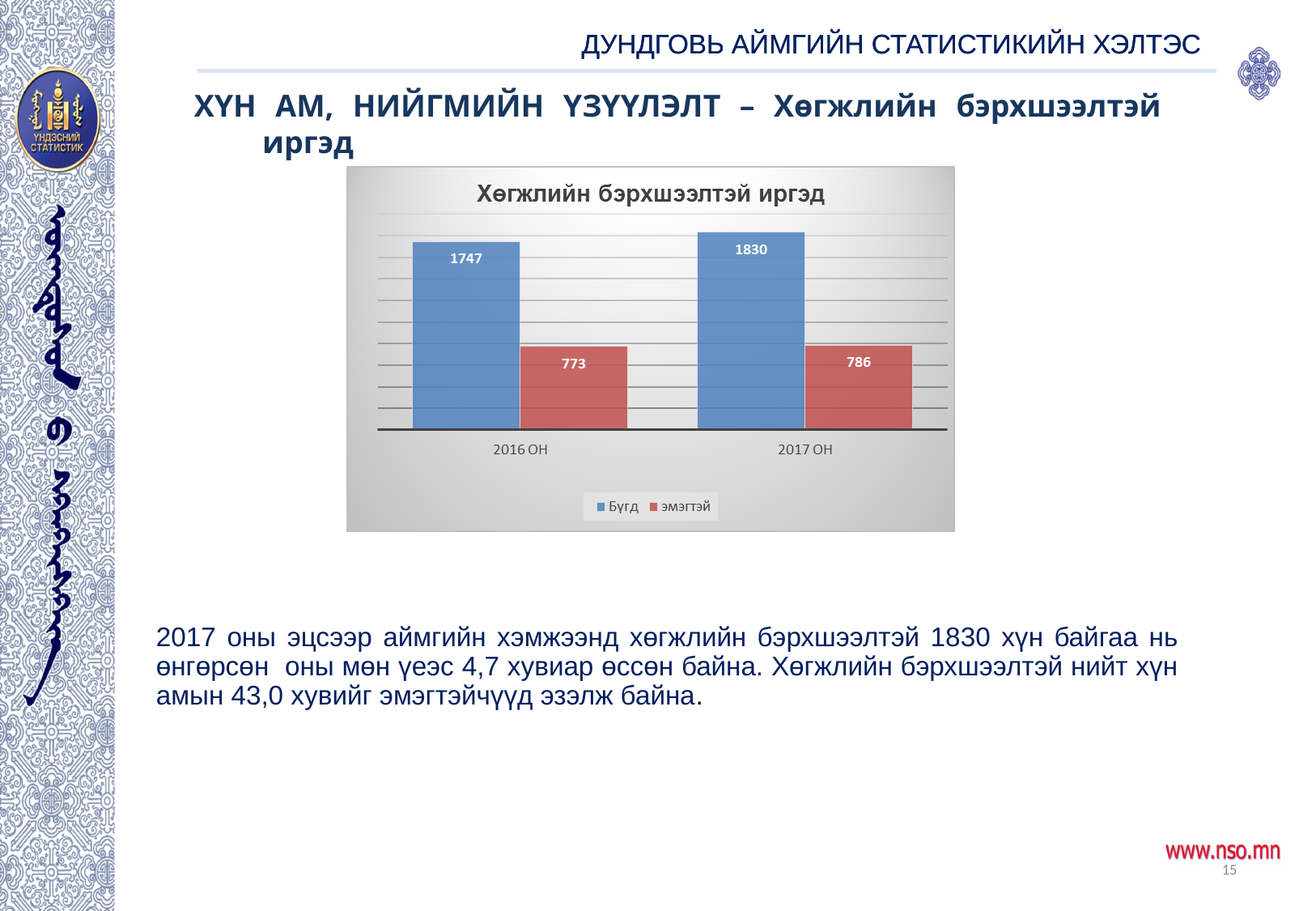
Which year has the higher value for Бүгд? 2017 ОН What is the value of Бүгд for 2016 ОН? 1747 What is the difference between the Бүгд values for 2017 ОН and 2016 ОН? 83 What is the title of the chart? Хөгжлийн бэрхшээлтэй иргэд What is the value of эмэгтэй for 2017 ОН? 786 Which is larger in 2016 ОН: Бүгд or эмэгтэй? Бүгд What kind of chart is shown? Bar chart How many categories are shown on the x axis? 2 What is the value of Бүгд for 2017 ОН? 1830 How many series does the legend list? 2 What is the value of эмэгтэй for 2016 ОН? 773 What is the difference between the эмэгтэй values for 2017 ОН and 2016 ОН? 13